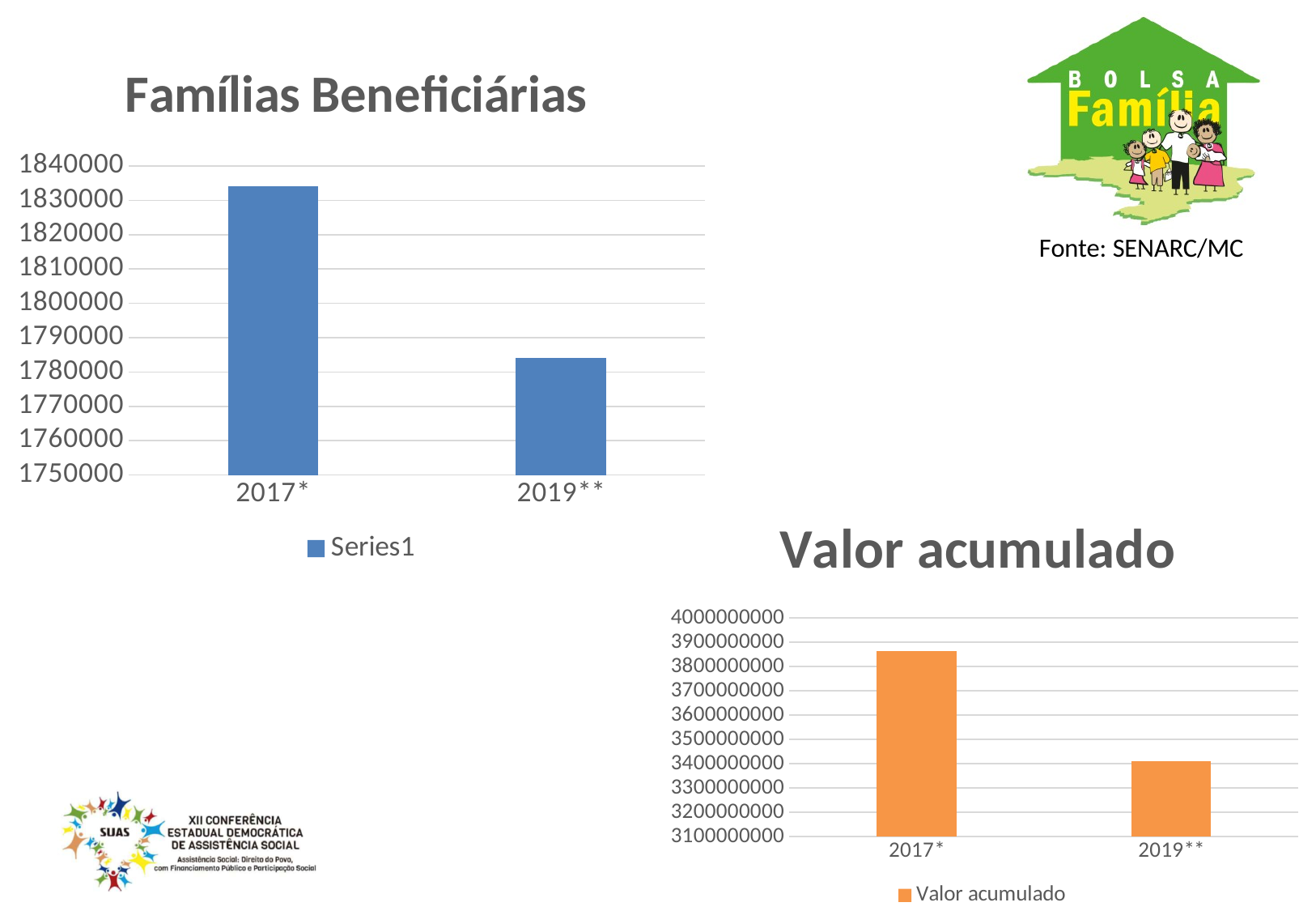
In the 'Famílias Beneficiárias' chart, do the values rise or fall from 2017* to 2019**? fall In the 'Famílias Beneficiárias' chart, is the value for 2017* greater or less than 1820000? greater How many series does the legend of the 'Valor acumulado' chart list? 1 In the 'Famílias Beneficiárias' chart, is the value for 2019** greater or less than 1790000? less How many categories are shown in the 'Valor acumulado' chart? 2 In the 'Valor acumulado' chart, which category has the higher value, 2017* or 2019**? 2017* In the 'Valor acumulado' chart, is the value for 2019** greater or less than 3500000000? less What is the legend entry shown below the 'Famílias Beneficiárias' chart? Series1 In the 'Famílias Beneficiárias' chart, which category has the highest value? 2017* What kind of chart is 'Famílias Beneficiárias'? bar chart In the 'Famílias Beneficiárias' chart, which category has the lowest value? 2019**